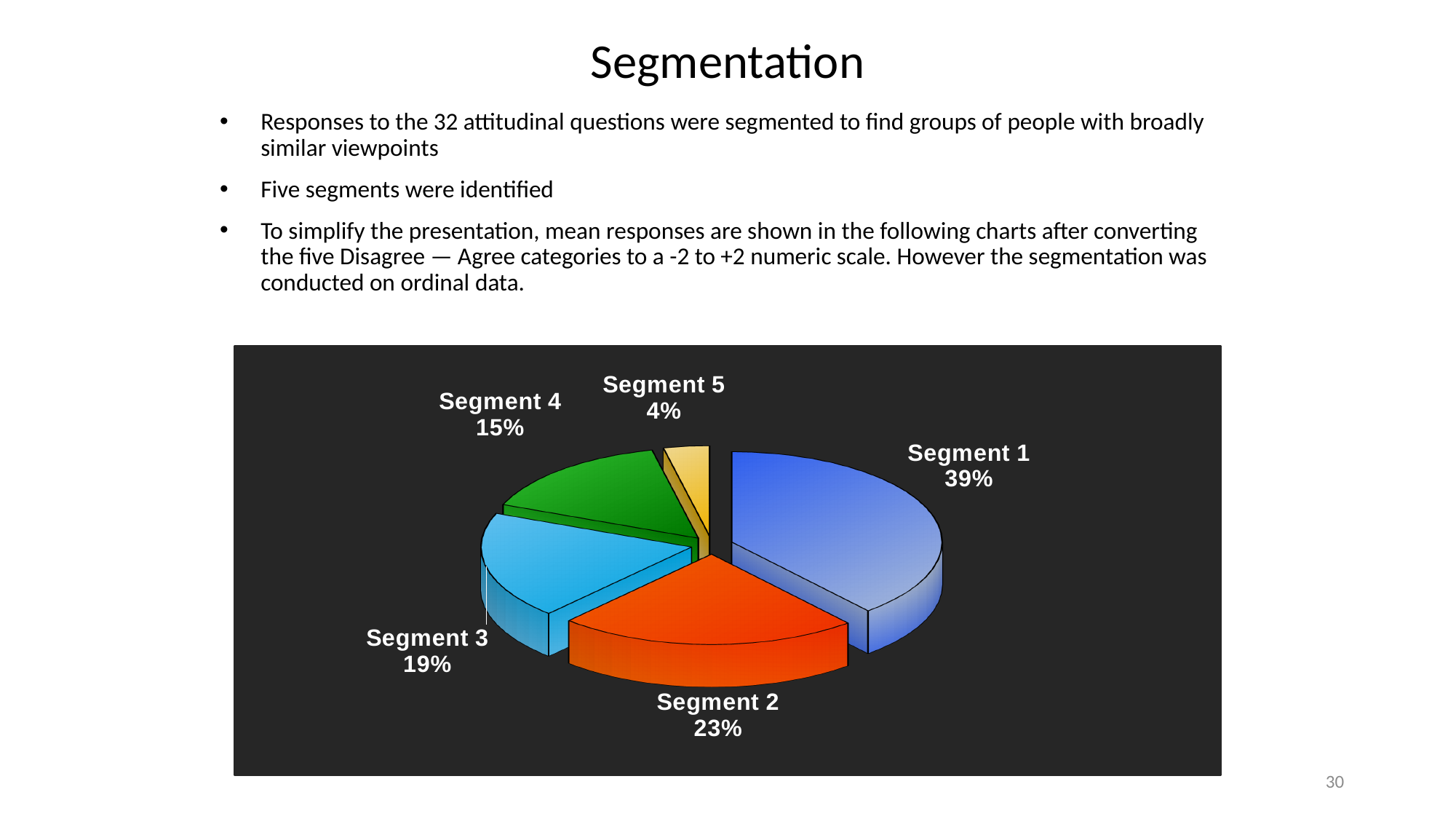
What kind of chart is shown on the slide? Pie chart Which is larger, Segment 2 or Segment 4? Segment 2 What colour is the slice for Segment 2? Orange What is the difference in percentage points between Segment 1 and Segment 2? 16 How many segments are shown in the pie chart? 5 Which segment has the smallest share of the pie? Segment 5 What share of the pie does Segment 3 represent? 19% Which segment has the largest share of the pie? Segment 1 What share of the pie does Segment 5 represent? 4% What share of the pie does Segment 1 represent? 39% What is the difference in percentage points between Segment 3 and Segment 4? 4 What colour is the slice for Segment 4? Green